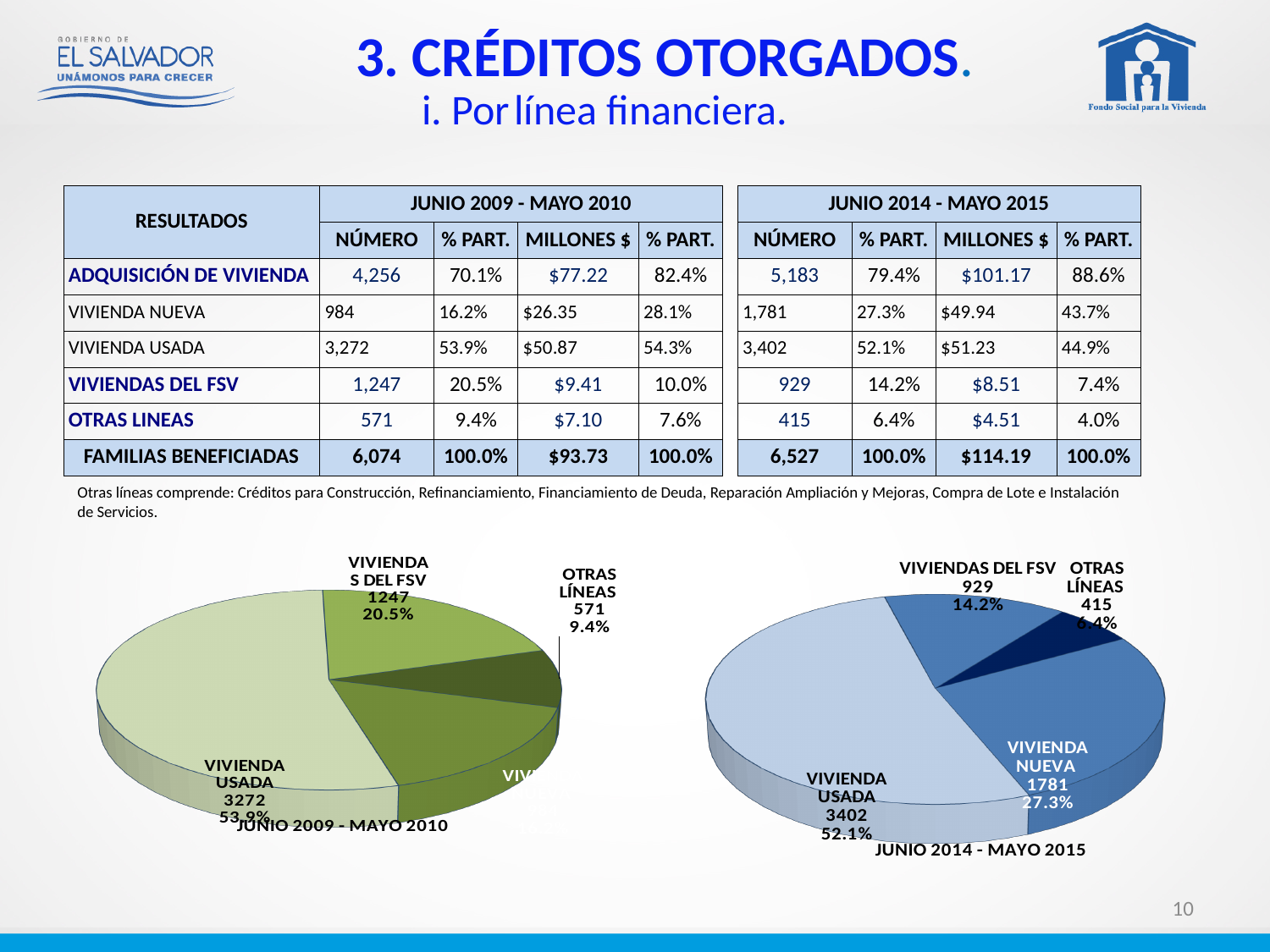
In the 'JUNIO 2009 - MAYO 2010' pie chart, what share does VIVIENDAS DEL FSV have? 20.5% In the 'JUNIO 2014 - MAYO 2015' pie chart, which category has the largest slice? VIVIENDA USADA How many slices does the 'JUNIO 2014 - MAYO 2015' pie chart have? 4 In the 'JUNIO 2014 - MAYO 2015' pie chart, what is the value shown for VIVIENDAS DEL FSV? 929 In the 'JUNIO 2009 - MAYO 2010' pie chart, what is the value shown for VIVIENDA USADA? 3272 In the 'JUNIO 2009 - MAYO 2010' pie chart, what is the value shown for OTRAS LÍNEAS? 571 In the 'JUNIO 2014 - MAYO 2015' pie chart, which category has the smallest slice? OTRAS LÍNEAS In the 'JUNIO 2009 - MAYO 2010' pie chart, which is larger, VIVIENDAS DEL FSV or OTRAS LÍNEAS? VIVIENDAS DEL FSV In the 'JUNIO 2014 - MAYO 2015' pie chart, what is the difference between the values for VIVIENDA NUEVA and VIVIENDAS DEL FSV? 852 What kind of chart is the 'JUNIO 2014 - MAYO 2015' chart? pie chart In the 'JUNIO 2014 - MAYO 2015' pie chart, what share does VIVIENDA NUEVA have? 27.3% In the 'JUNIO 2014 - MAYO 2015' pie chart, what is the value shown for VIVIENDA USADA? 3402